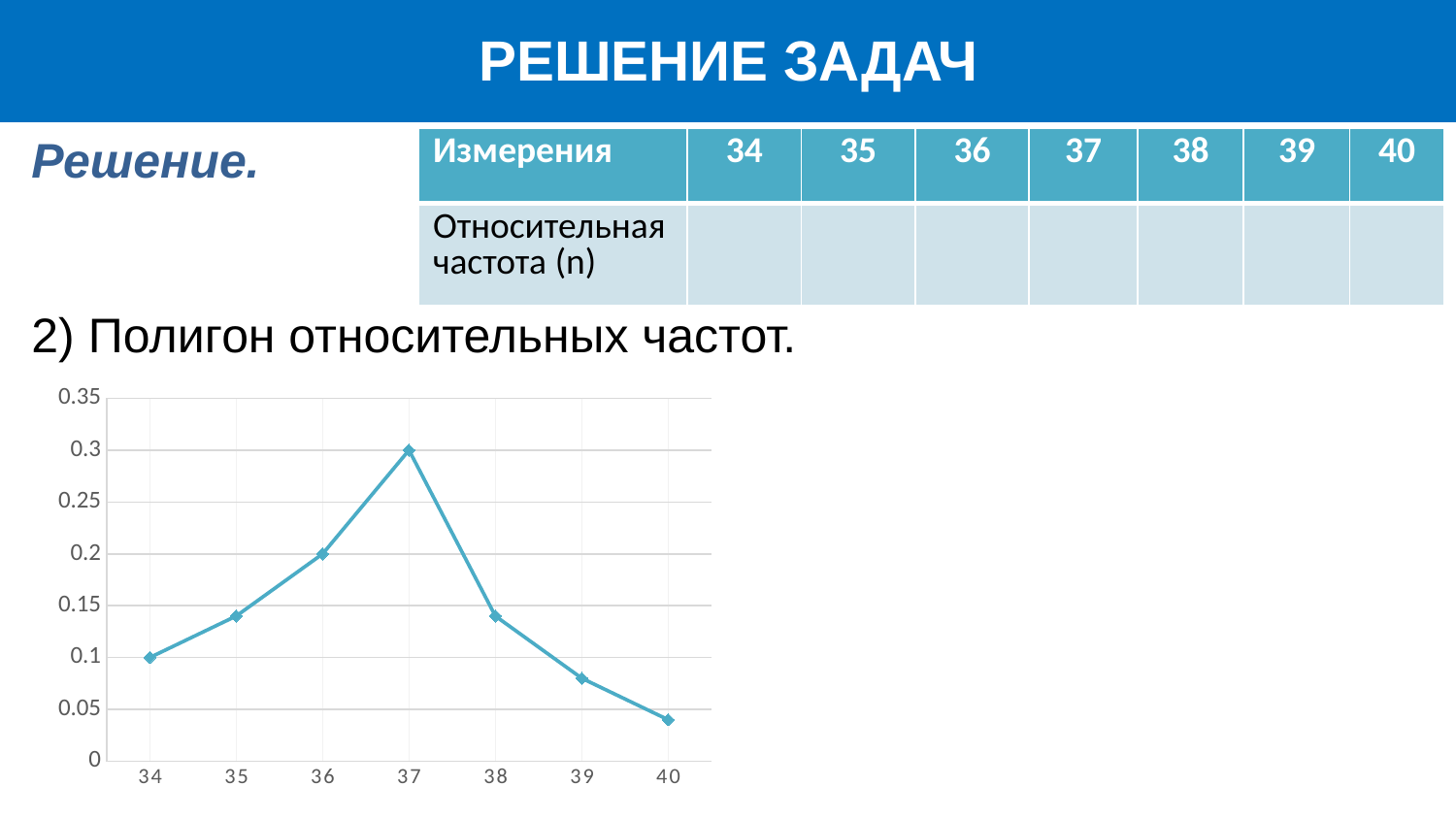
What kind of chart is shown on the slide? line chart Which x-axis category has the lowest value? 40 How many data points are plotted on the line chart? 7 Is the value for 39 greater or less than 0.1? less Is the value for 38 greater or less than 0.1? greater What is the value plotted for 36? 0.2 Do the values rise or fall from 37 to 40 along the x axis? fall Which has the larger value, 36 or 38? 36 Which x-axis category has the highest value? 37 What is the value plotted for 34? 0.1 What is the value plotted for 37? 0.3